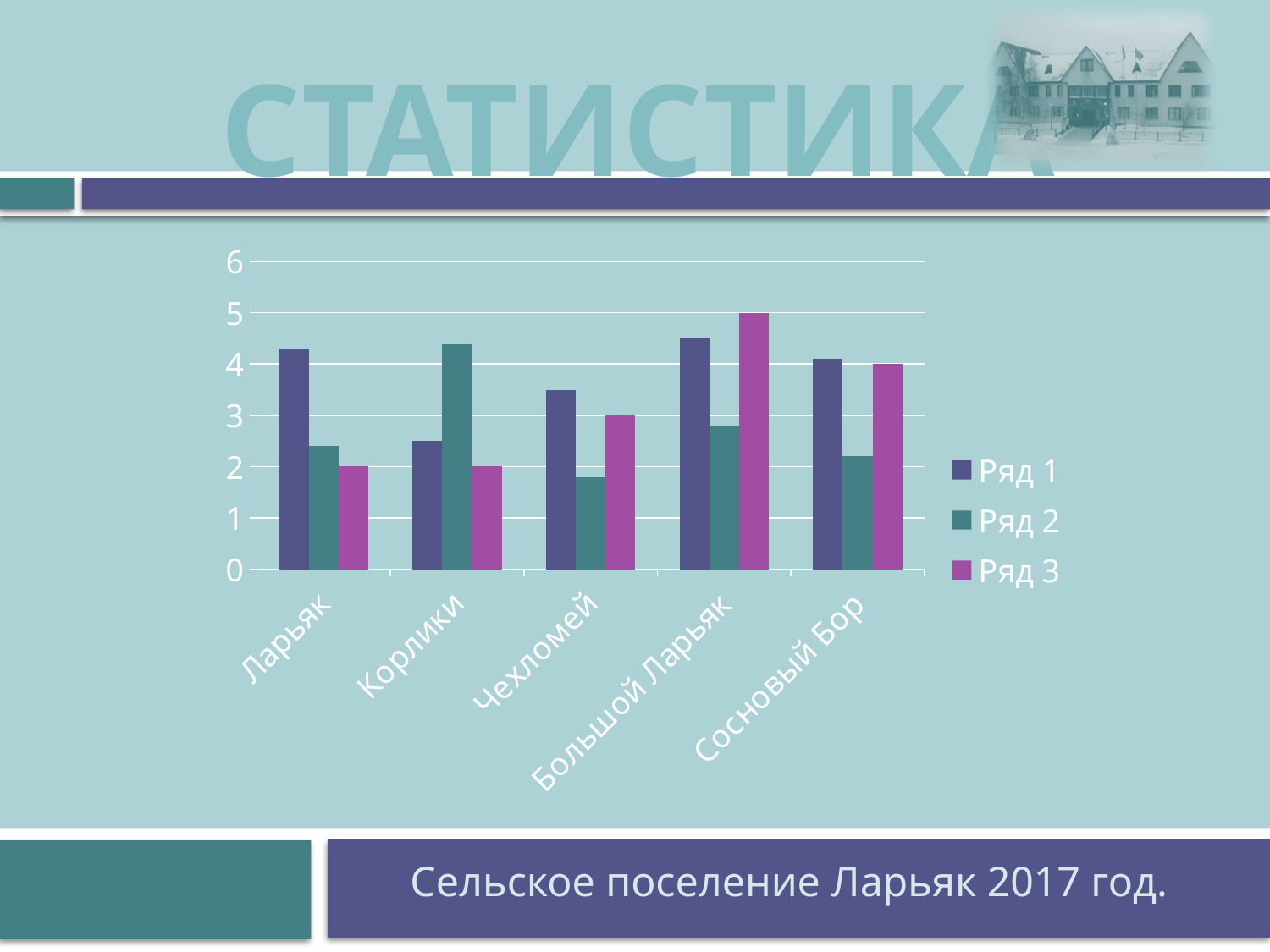
What is the value of Ряд 3 for Чехломей? 3 Which category has the highest value for Ряд 3? Большой Ларьяк Is the value of Ряд 1 for Ларьяк greater or less than 4? greater For Ларьяк, which is larger: Ряд 1 or Ряд 2? Ряд 1 How many categories are shown on the x axis? 5 What is the value of Ряд 3 for Большой Ларьяк? 5 Which category has the lowest value for Ряд 1? Корлики Is the value of Ряд 2 for Чехломей greater or less than 2? less How many series does the legend list? 3 Which category has the highest value for Ряд 2? Корлики What is the value of Ряд 3 for Сосновый Бор? 4 What is the difference between the Ряд 3 values for Большой Ларьяк and Сосновый Бор? 1